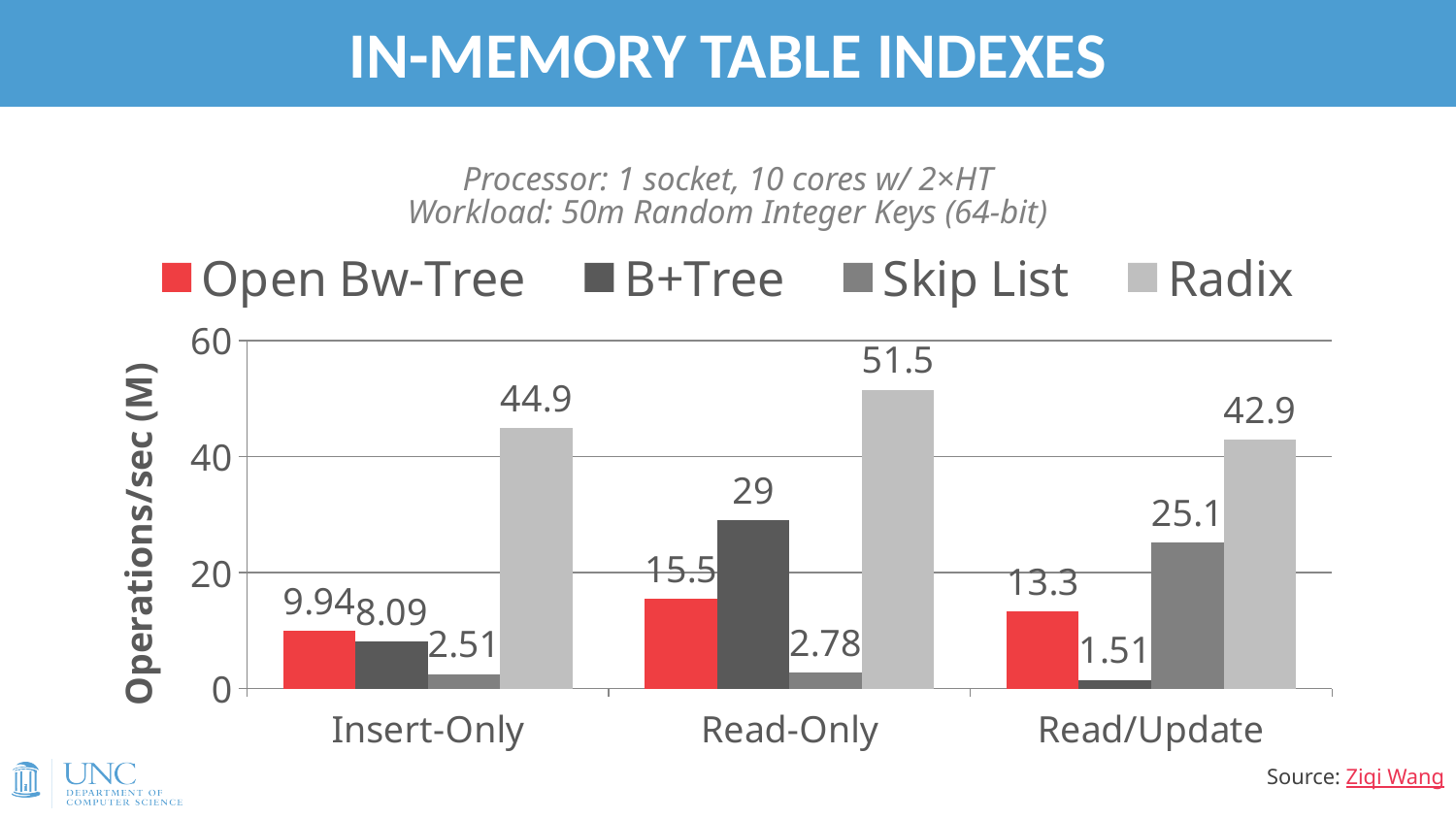
What kind of chart is shown on the slide? Bar chart What is the Radix value for Read-Only? 51.5 What is the Skip List value for Read/Update? 25.1 Which series has the highest value for Read/Update? Radix What is the label of the y axis? Operations/sec (M) What is the difference between the Radix and Open Bw-Tree values for Read-Only? 36 What is the Open Bw-Tree value for Insert-Only? 9.94 How many workload categories are shown on the x axis? 3 What is the B+Tree value for Read-Only? 29 Which is larger for Read/Update: Open Bw-Tree or B+Tree? Open Bw-Tree How many series does the legend list? 4 Which series has the lowest value for Insert-Only? Skip List